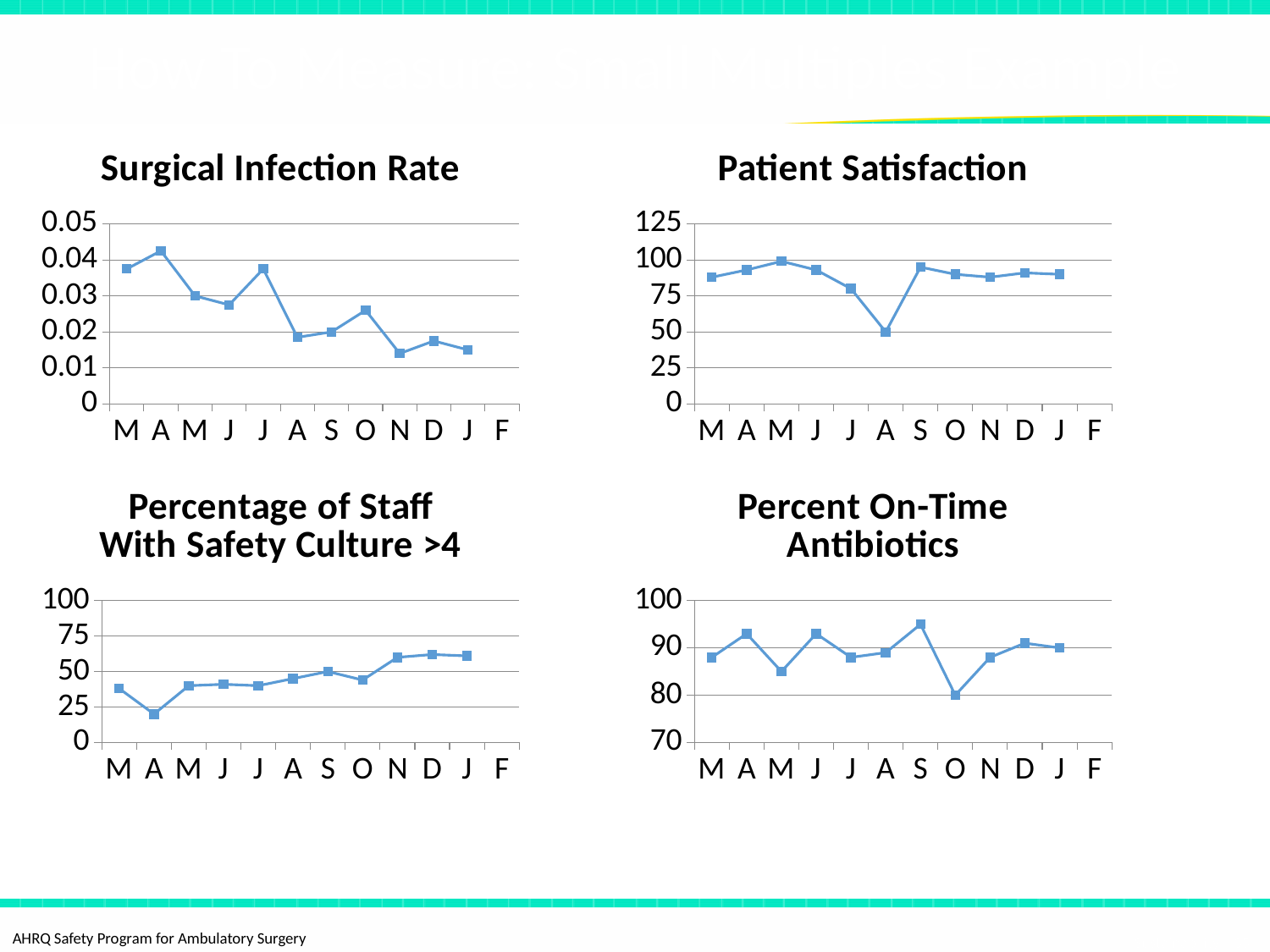
In the Patient Satisfaction chart, which month has the lowest value? A (August, the second A) In the Surgical Infection Rate chart, which is larger, the value for S or the value for O? O In the Surgical Infection Rate chart, do the values generally rise or fall from left to right along the x axis? fall In the Percent On-Time Antibiotics chart, is the value for S greater or less than 90? greater How many month labels are shown on the x axis of the Patient Satisfaction chart? 12 In the Surgical Infection Rate chart, is the value for N greater or less than 0.02? less In the Surgical Infection Rate chart, is the value for O greater or less than 0.02? greater In the Percentage of Staff With Safety Culture >4 chart, do the values generally rise or fall from left to right along the x axis? rise What type of chart is the Surgical Infection Rate chart? line chart In the Percent On-Time Antibiotics chart, which month has the lowest value? O